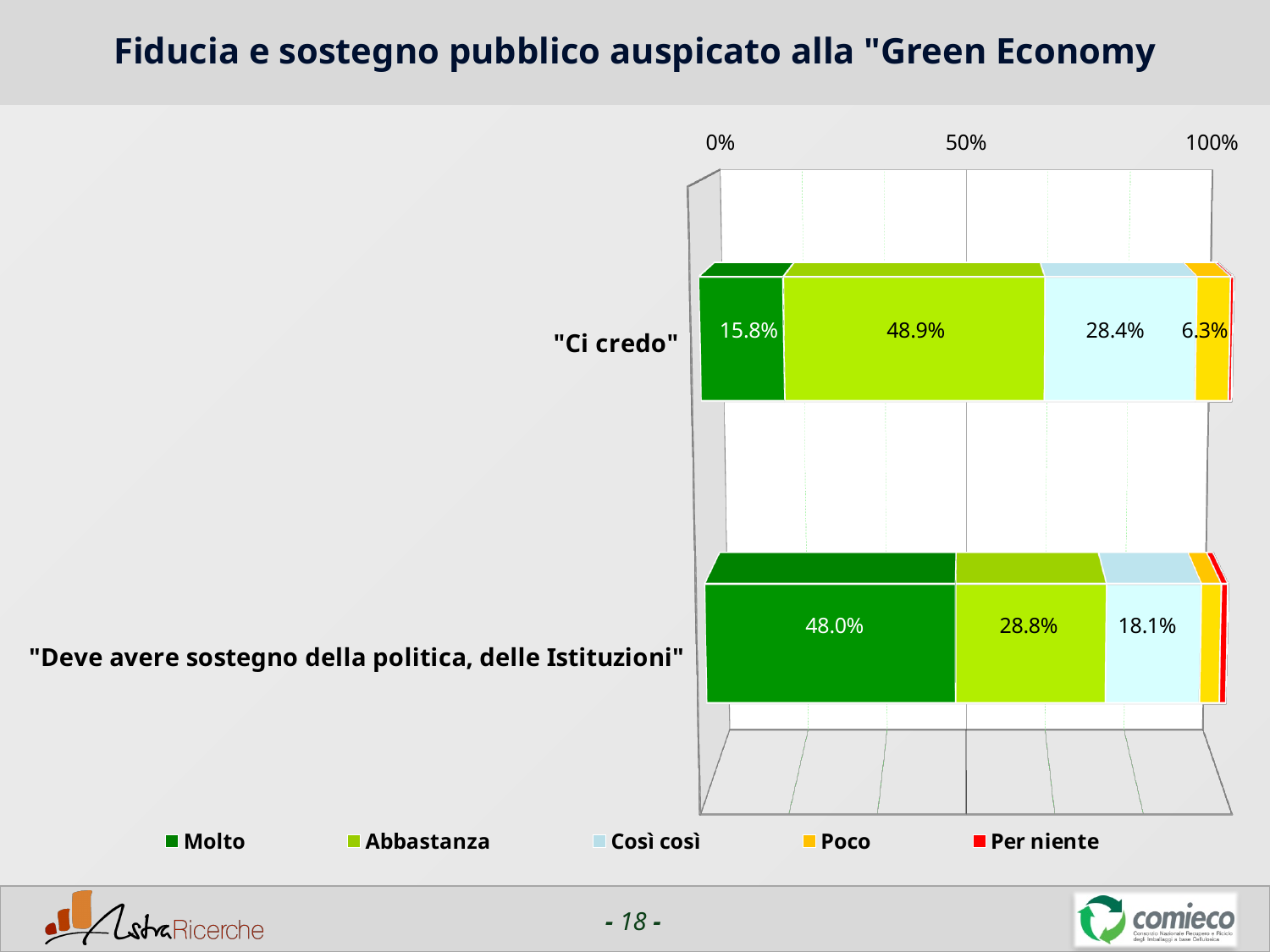
How many categories are plotted on the chart? 2 What is the "Abbastanza" value for "Ci credo"? 48.9% Which category has the larger "Abbastanza" value, "Ci credo" or "Deve avere sostegno della politica, delle Istituzioni"? "Ci credo" What is the "Molto" value for "Deve avere sostegno della politica, delle Istituzioni"? 48.0% What is the "Molto" value for "Ci credo"? 15.8% Which series is shown in red in the legend? Per niente What is the difference between the "Molto" values for "Deve avere sostegno della politica, delle Istituzioni" and "Ci credo"? 32.2% What is the "Così così" value for "Deve avere sostegno della politica, delle Istituzioni"? 18.1% What is the "Poco" value for "Ci credo"? 6.3% How many series does the legend list? 5 What kind of chart is shown on the slide? stacked bar chart What is the "Così così" value for "Ci credo"? 28.4%